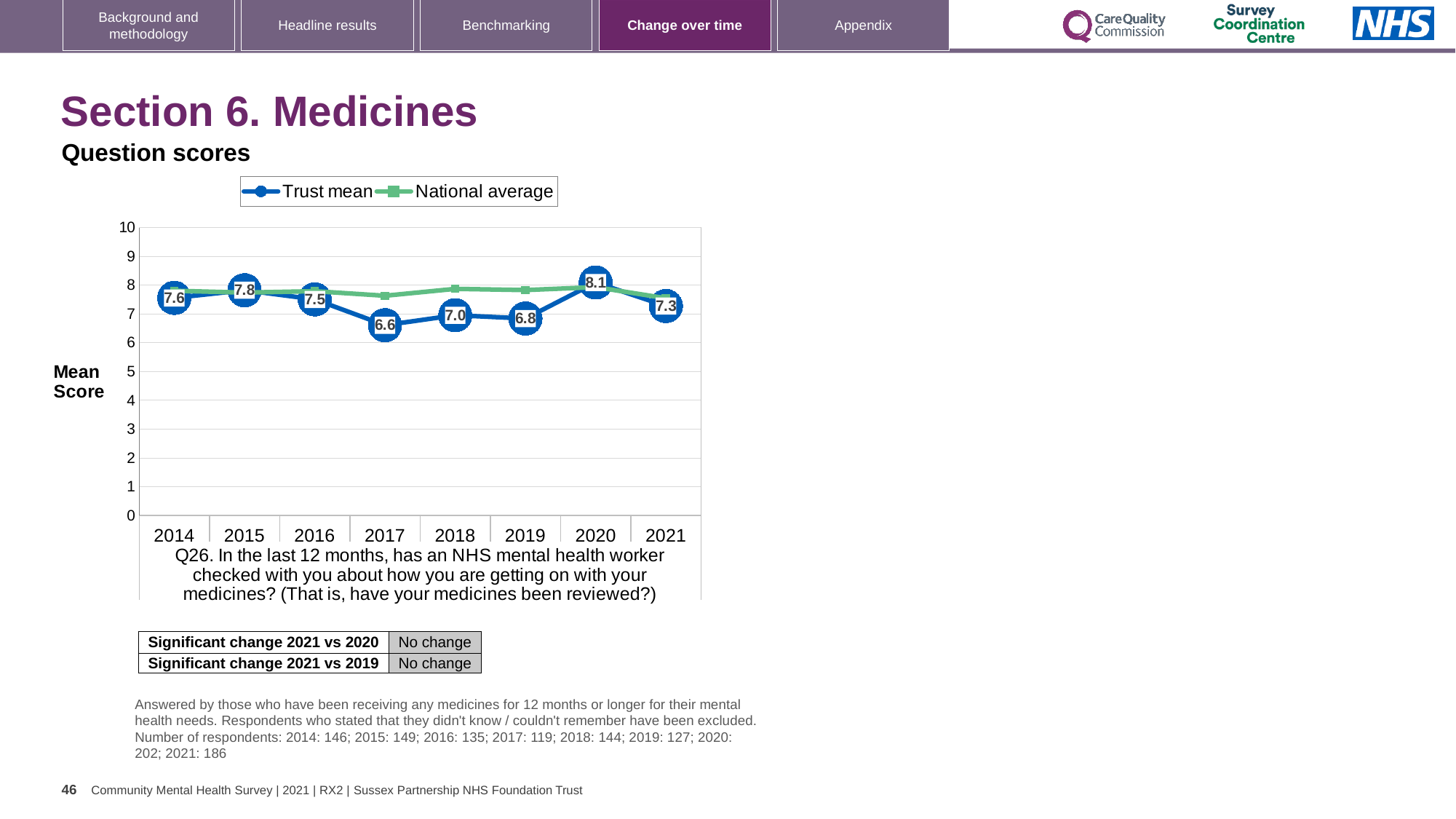
What is the Trust mean score for 2017? 6.6 What kind of chart is shown on the slide? Line chart What is the Trust mean score for 2020? 8.1 Is the National average value for 2017 greater or less than 7? greater What is the difference between the Trust mean score in 2020 and in 2017? 1.5 How many series does the chart legend list? 2 Does the Trust mean score rise or fall from 2020 to 2021? Fall In which year is the Trust mean score lowest? 2017 How many years are shown on the x axis of the chart? 8 Which year has the larger Trust mean score, 2015 or 2021? 2015 What is the Trust mean score for 2014? 7.6 In which year is the Trust mean score highest? 2020